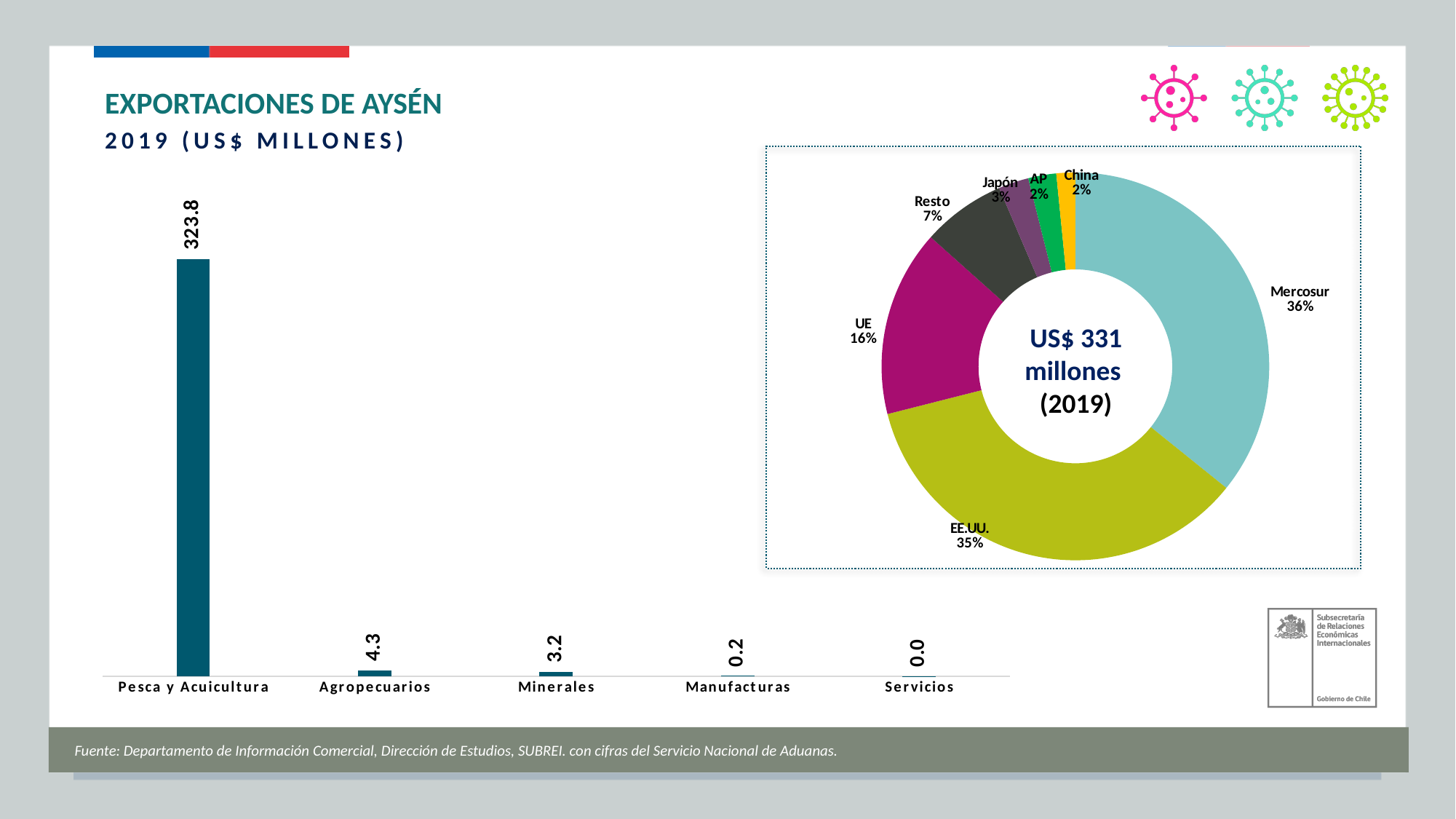
In the bar chart on the left, which category has the lowest value? Servicios In the bar chart on the left, how many categories are shown? 5 In the bar chart on the left, what is the value for Pesca y Acuicultura? 323.8 In the donut chart on the right, what share does UE have? 16% In the bar chart on the left, what is the difference between Agropecuarios and Minerales? 1.1 In the donut chart on the right, what share does Mercosur have? 36% In the donut chart on the right, which is larger, EE.UU. or Resto? EE.UU. What kind of chart is shown on the left of the slide? Bar chart What total value is shown in the centre of the donut chart on the right? US$ 331 millones In the bar chart on the left, what is the value for Minerales? 3.2 In the bar chart on the left, what is the value for Agropecuarios? 4.3 In the bar chart on the left, which category has the highest value? Pesca y Acuicultura